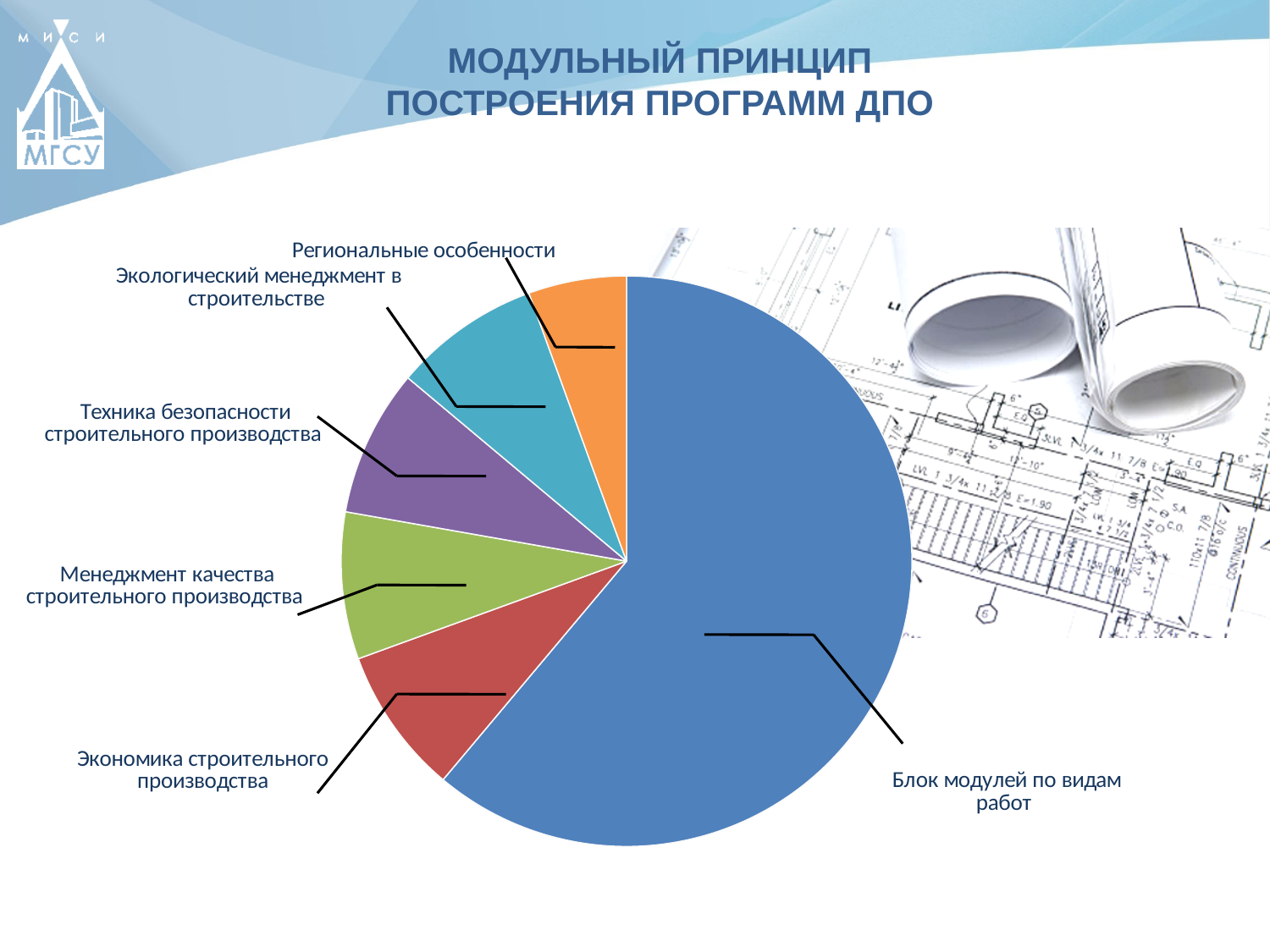
What kind of chart is shown on the slide? pie chart Does the slice for Блок модулей по видам работ take up more or less than half of the pie? more How many slices does the pie chart have? 6 What colour is the slice for Региональные особенности? orange Which category has the smallest slice of the pie chart? Региональные особенности Which category has the largest slice of the pie chart? Блок модулей по видам работ What colour is the slice for Блок модулей по видам работ? blue Which slice is larger: Региональные особенности or Менеджмент качества строительного производства? Менеджмент качества строительного производства Which slice is larger: Экономика строительного производства or Региональные особенности? Экономика строительного производства Which slice is larger: Блок модулей по видам работ or Экономика строительного производства? Блок модулей по видам работ